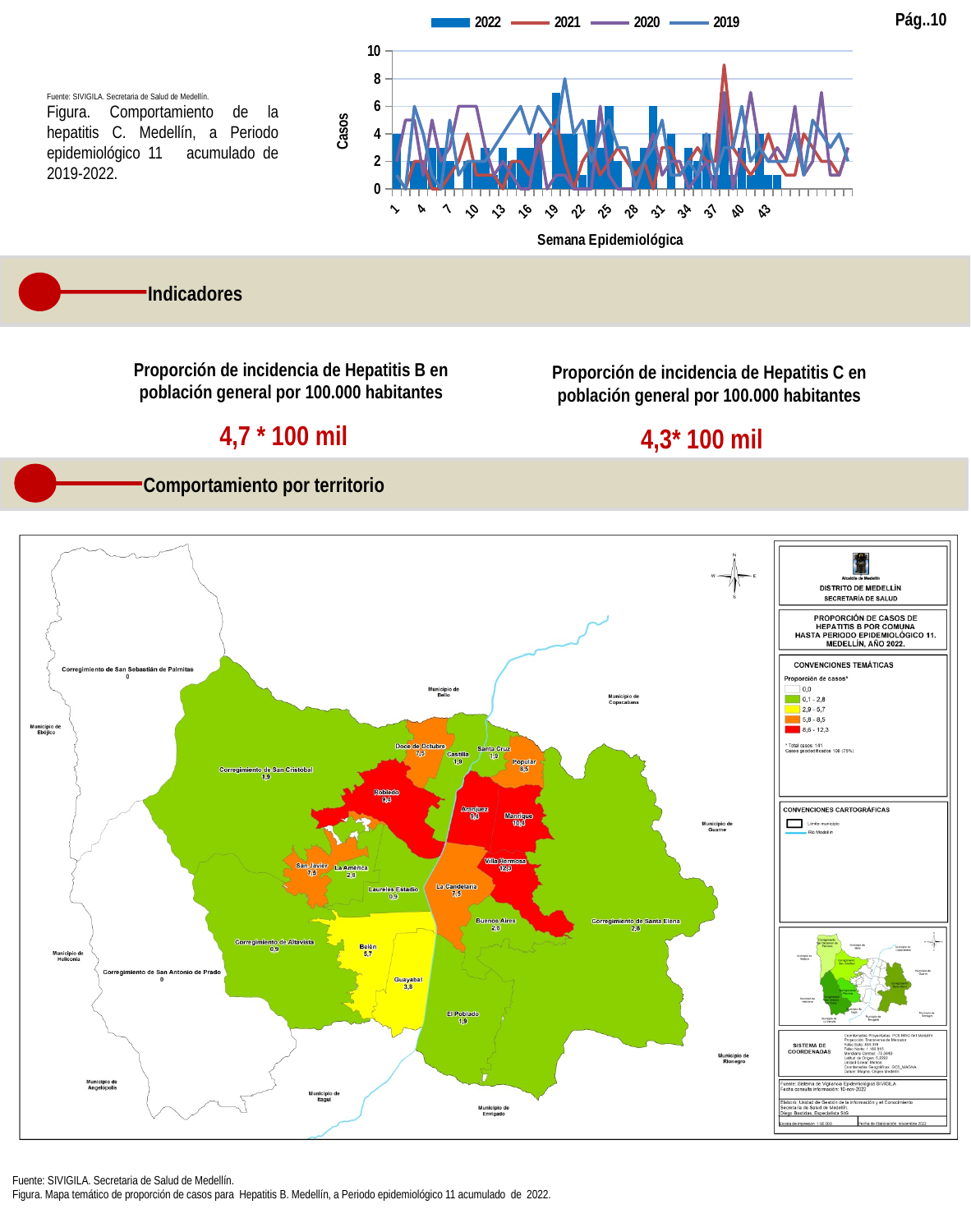
In the top chart, what is the title of the vertical axis? Casos In the top chart, which series is drawn as bars rather than a line? 2022 In the top chart, is the highest peak of the 2021 line greater or less than 8? greater In the top chart, how many series does the legend list? 4 On the map of hepatitis B proportion by comuna, what is the value printed for Manrique? 10,4 In the top chart, what is the title of the horizontal axis? Semana Epidemiológica In the top chart, what is the highest value shown on the vertical axis? 10 In the top chart, which series reaches the highest single peak? 2021 On the map of hepatitis B proportion by comuna, which comuna has the highest printed value? Villa Hermosa In the top chart, what are the legend entries? 2022, 2021, 2020, 2019 What kind of chart is the top chart of hepatitis C cases? Combined bar and line chart On the map of hepatitis B proportion by comuna, what is the value printed for Villa Hermosa? 12,3